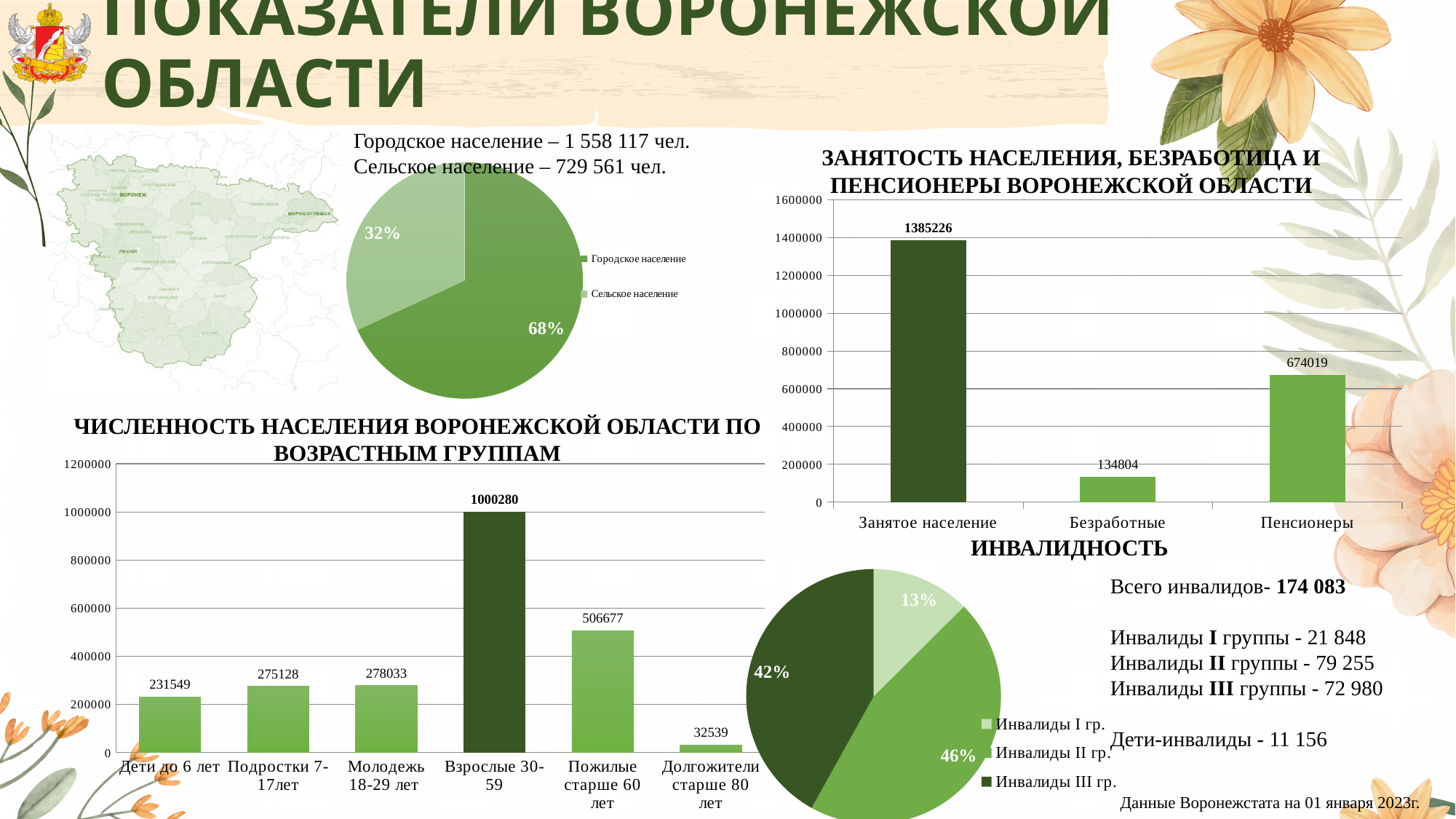
What type of chart is 'Занятость населения, безработица и пенсионеры Воронежской области'? Bar chart In the chart 'Численность населения Воронежской области по возрастным группам', what is the value for 'Взрослые 30-59'? 1000280 In the pie chart at the top of the slide showing urban and rural population, what share does 'Сельское население' have? 32% How many entries does the legend of the pie chart 'Инвалидность' list? 3 In the pie chart 'Инвалидность', which group has the largest share? Инвалиды II гр. In the chart 'Занятость населения, безработица и пенсионеры Воронежской области', what is the difference between 'Занятое население' and 'Пенсионеры'? 711207 In the chart 'Занятость населения, безработица и пенсионеры Воронежской области', which category has the highest value? Занятое население In the chart 'Численность населения Воронежской области по возрастным группам', which age group has the lowest value? Долгожители старше 80 лет In the chart 'Численность населения Воронежской области по возрастным группам', what is the difference between 'Пожилые старше 60 лет' and 'Дети до 6 лет'? 275128 In the chart 'Занятость населения, безработица и пенсионеры Воронежской области', what is the value for 'Безработные'? 134804 In the pie chart 'Инвалидность', what share does 'Инвалиды I гр.' have? 13% How many age groups are shown in the chart 'Численность населения Воронежской области по возрастным группам'? 6